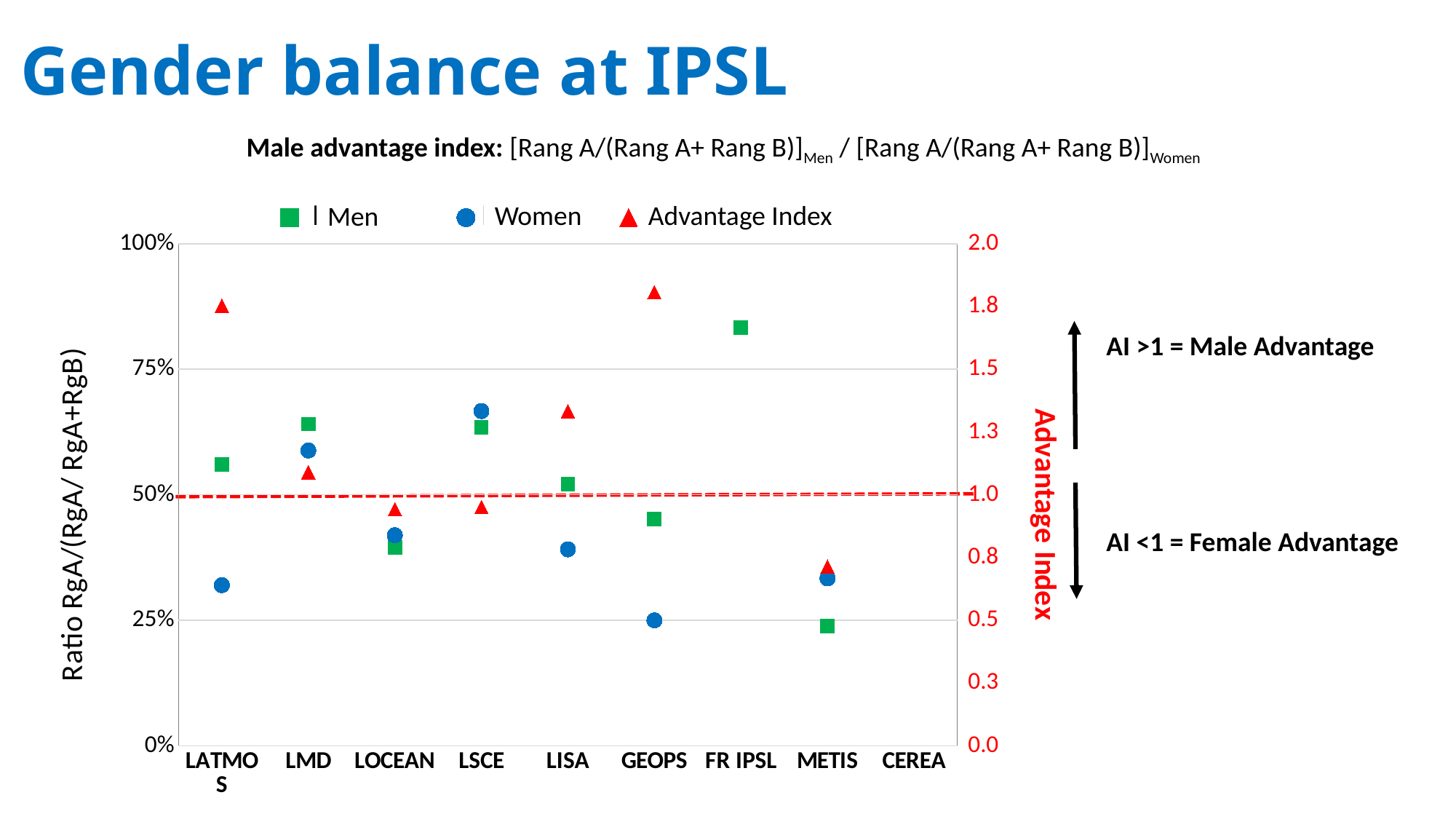
Which laboratory has the highest Women value? LSCE Which laboratory has the lowest Men value? METIS Which laboratory has the lowest Women value? GEOPS Is the Advantage Index for METIS greater or less than 1.0? less What kind of chart is this? Scatter chart What value on the right axis does the red dashed horizontal line mark? 1.0 Which laboratory has the highest Men value? FR IPSL At GEOPS, which is larger, the Men value or the Women value? Men Is the Men value for FR IPSL greater or less than 75%? greater Is the Advantage Index for GEOPS greater or less than 1.5? greater How many laboratories are shown along the x axis? 9 How many series does the legend list? 3